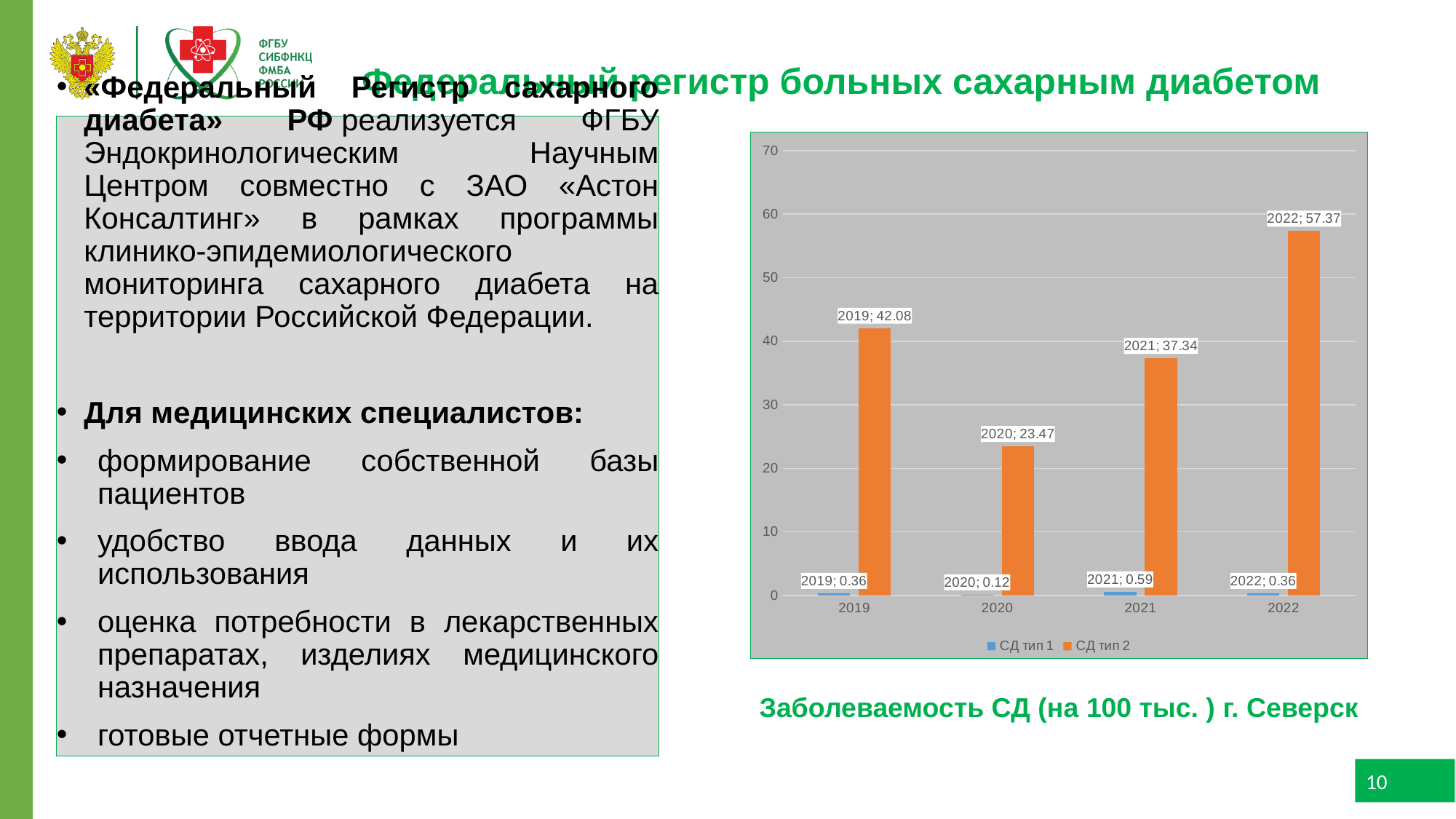
What caption is printed below the chart? Заболеваемость СД (на 100 тыс. ) г. Северск What is the value for СД тип 1 in 2021? 0.59 How many series does the legend list? 2 What is the difference between the СД тип 2 values for 2022 and 2021? 20.03 What is the value for СД тип 2 in 2022? 57.37 Which is larger, the СД тип 2 value for 2019 or for 2021? 2019 In which year is the value for СД тип 2 lowest? 2020 What kind of chart is shown on the slide? Bar chart What is the value for СД тип 1 in 2020? 0.12 How many years are shown on the x axis? 4 In which year is the value for СД тип 2 highest? 2022 What is the value for СД тип 2 in 2020? 23.47